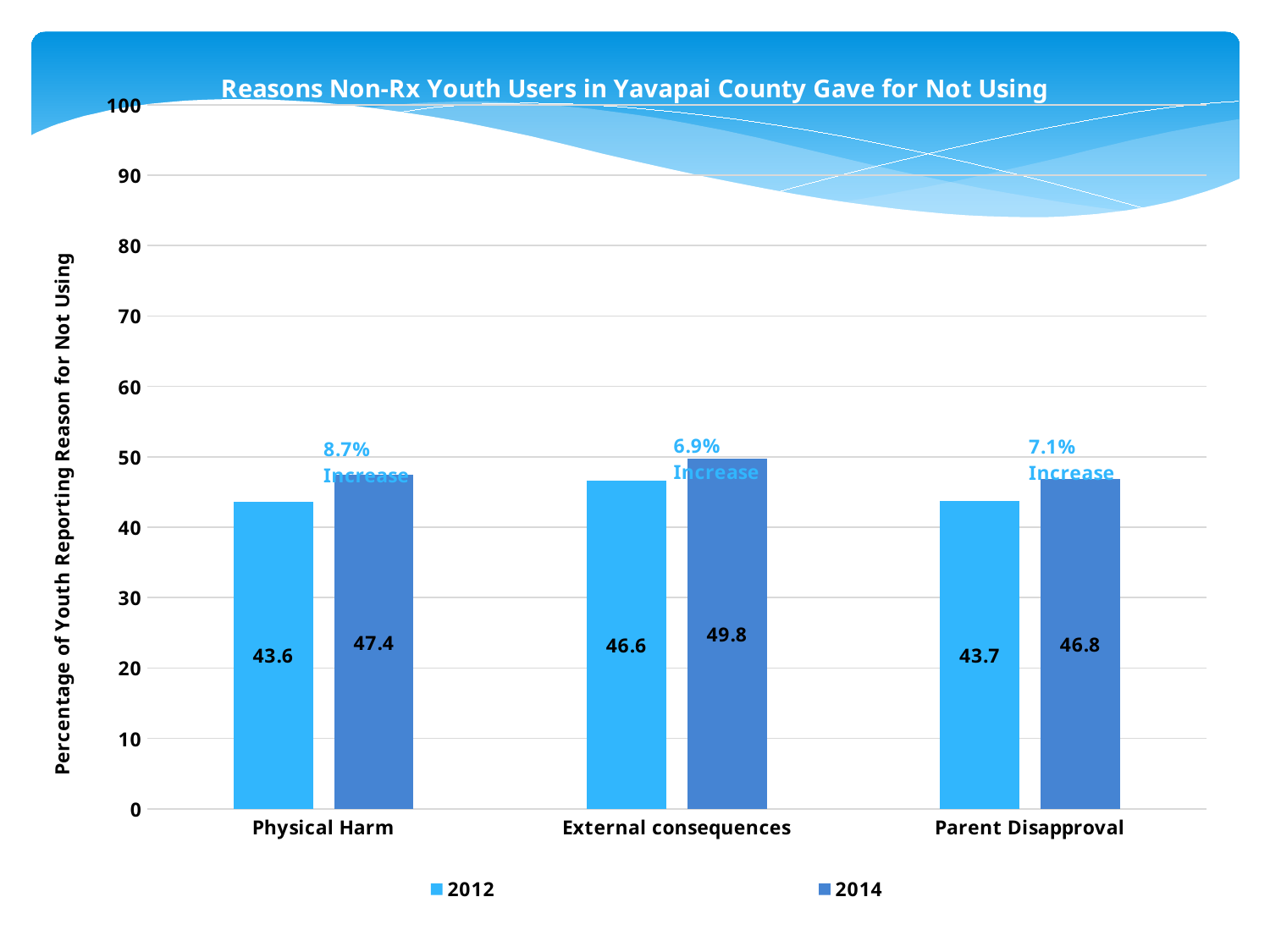
What is the 2012 value for Parent Disapproval? 43.7 What is the difference between the 2014 and 2012 values for Physical Harm? 3.8 Which category has the highest 2014 value? External consequences What is the 2012 value for Physical Harm? 43.6 Which category has the lowest 2012 value? Physical Harm How many series does the legend list? 2 What kind of chart is shown on the slide? Bar chart What is the 2014 value for External consequences? 49.8 Which is larger, the 2012 value for External consequences or the 2014 value for Parent Disapproval? 2012 value for External consequences What is the 2014 value for Parent Disapproval? 46.8 What percentage increase is annotated above the External consequences bars? 6.9% Increase How many categories are shown on the x axis? 3